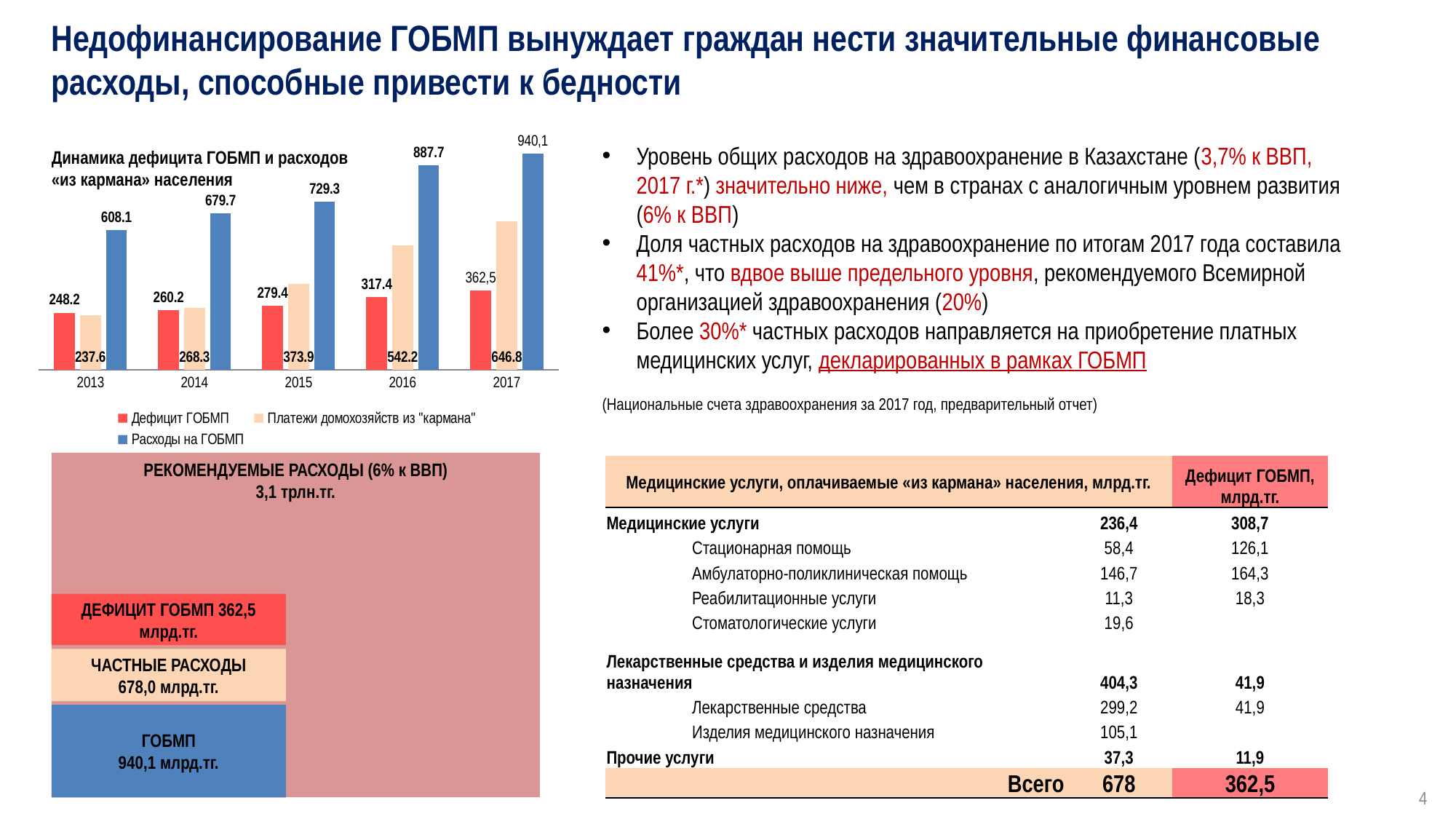
In the chart «Динамика дефицита ГОБМП и расходов «из кармана» населения», what is the value of Дефицит ГОБМП for 2017? 362,5 In the chart «Динамика дефицита ГОБМП и расходов «из кармана» населения», which year has the lowest value of Платежи домохозяйств из "кармана"? 2013 In the chart «Динамика дефицита ГОБМП и расходов «из кармана» населения», what is the value of Платежи домохозяйств из "кармана" for 2016? 542.2 In the chart «Динамика дефицита ГОБМП и расходов «из кармана» населения», what is the difference between Платежи домохозяйств из "кармана" in 2017 and in 2016? 104.6 In the chart «Динамика дефицита ГОБМП и расходов «из кармана» населения», which year has the highest value of Расходы на ГОБМП? 2017 In the chart «Динамика дефицита ГОБМП и расходов «из кармана» населения», what is the value of Расходы на ГОБМП for 2015? 729.3 How many years are shown on the x axis of the chart «Динамика дефицита ГОБМП и расходов «из кармана» населения»? 5 What kind of chart is «Динамика дефицита ГОБМП и расходов «из кармана» населения»? Bar chart How many series does the legend of the chart «Динамика дефицита ГОБМП и расходов «из кармана» населения» list? 3 In the chart «Динамика дефицита ГОБМП и расходов «из кармана» населения», which is larger in 2013: Дефицит ГОБМП or Платежи домохозяйств из "кармана"? Дефицит ГОБМП In the chart «Динамика дефицита ГОБМП и расходов «из кармана» населения», do the values of Расходы на ГОБМП rise or fall from 2013 to 2017? Rise In the chart «Динамика дефицита ГОБМП и расходов «из кармана» населения», what is the difference between Расходы на ГОБМП in 2016 and in 2015? 158.4